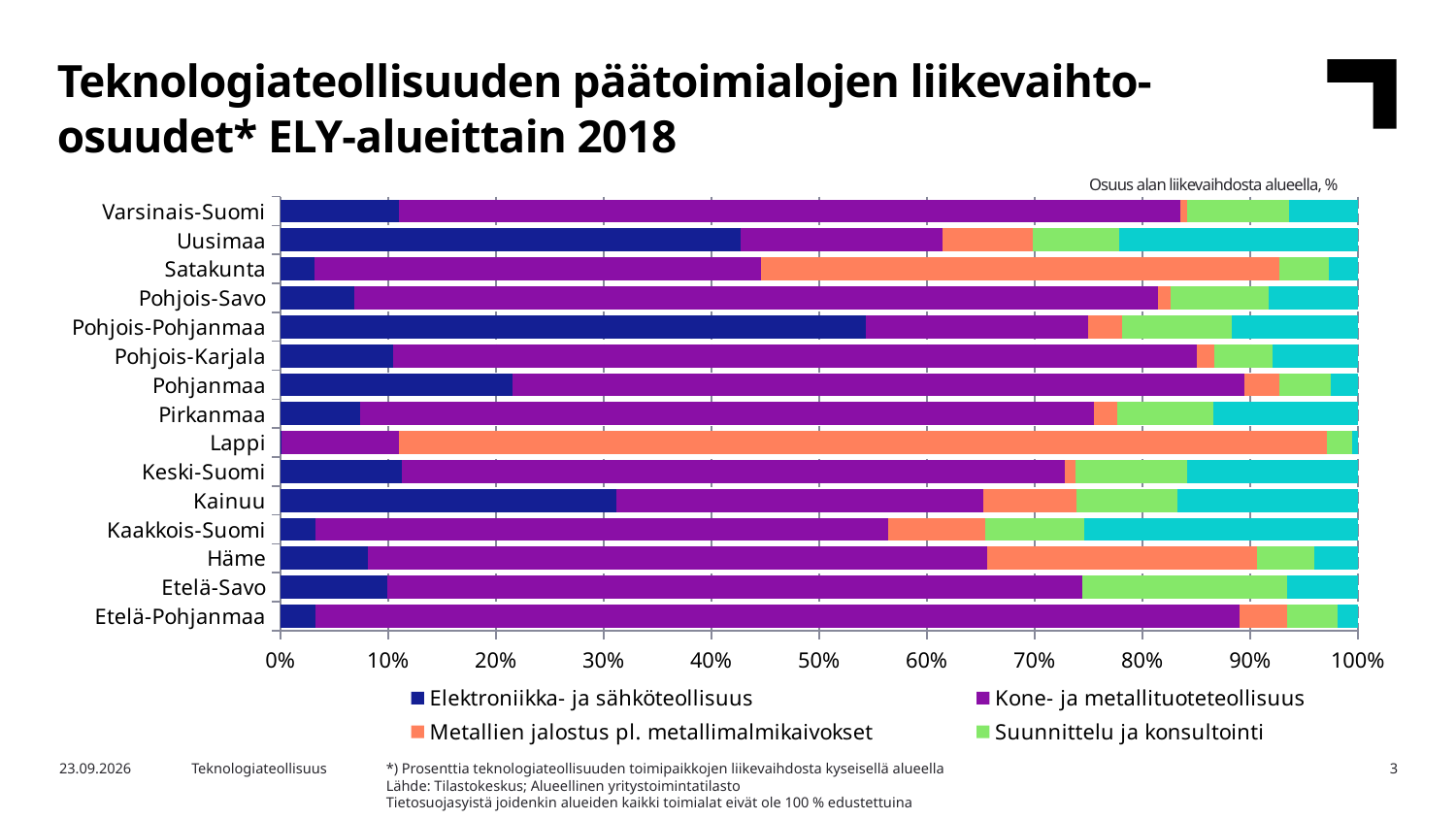
Which region is listed at the top of the chart? Varsinais-Suomi Which region has the largest share for Kone- ja metallituoteteollisuus? Etelä-Pohjanmaa How many ELY regions are listed on the chart? 15 How many series does the legend list? 4 Which has the larger Metallien jalostus pl. metallimalmikaivokset share, Satakunta or Uusimaa? Satakunta Is the Elektroniikka- ja sähköteollisuus share for Uusimaa greater or less than 40%? greater Is the Elektroniikka- ja sähköteollisuus share for Pohjois-Pohjanmaa greater or less than 50%? greater Is the Elektroniikka- ja sähköteollisuus share for Satakunta greater or less than 10%? less Which has the larger Elektroniikka- ja sähköteollisuus share, Uusimaa or Pirkanmaa? Uusimaa Which region has the largest share for Elektroniikka- ja sähköteollisuus? Pohjois-Pohjanmaa What kind of chart is shown on the slide? Stacked bar chart Which region has the largest share for Metallien jalostus pl. metallimalmikaivokset? Lappi